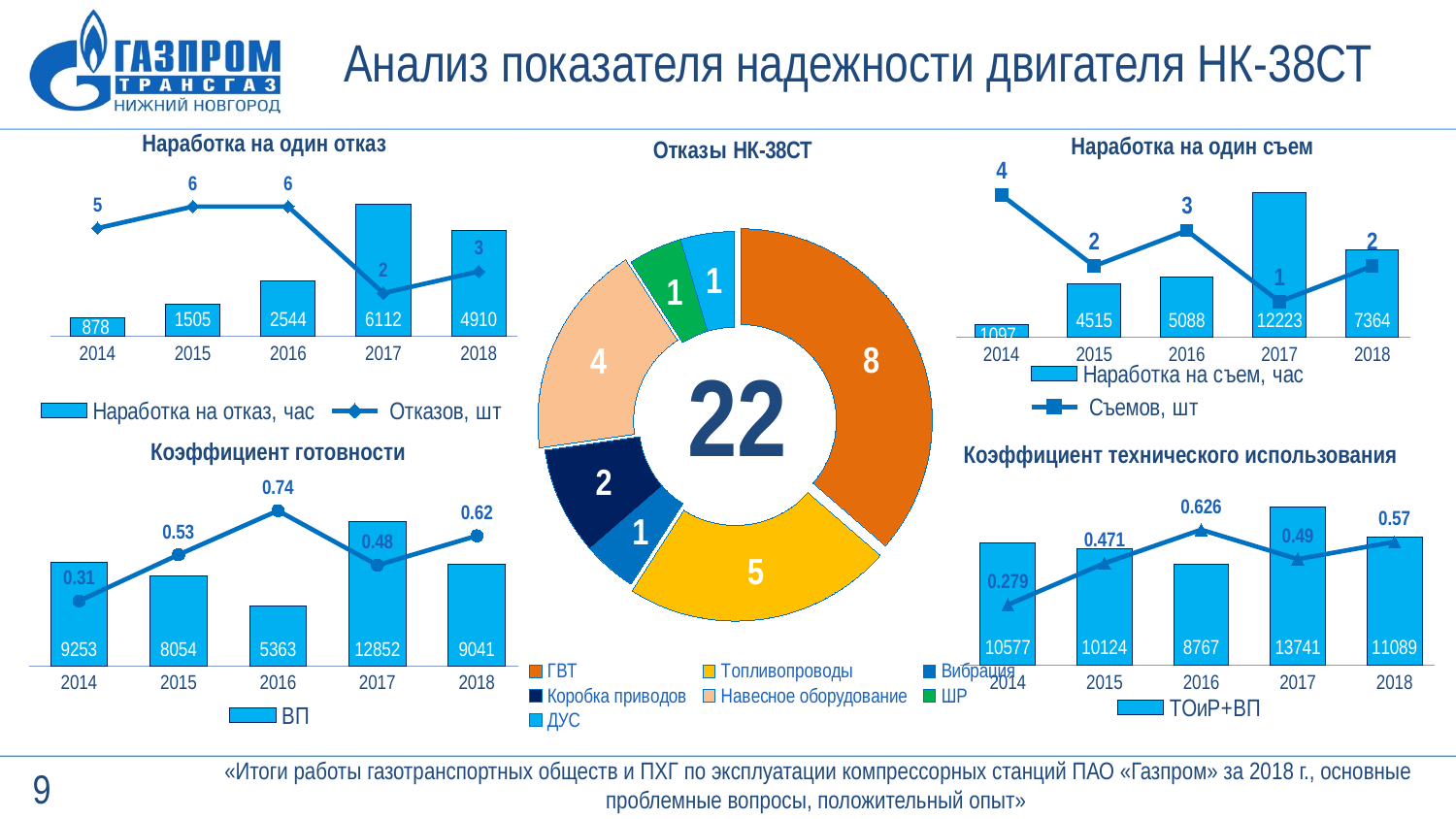
How many entries does the legend of the 'Отказы НК-38СТ' chart list? 7 How many years are shown on the x axis of the 'Коэффициент технического использования' chart? 5 In the 'Наработка на один отказ' chart, which year has the highest number of 'Отказов, шт'? 2015 and 2016 In the 'Наработка на один отказ' chart, what is the value of 'Наработка на отказ, час' for 2017? 6112 In the 'Отказы НК-38СТ' donut chart, what is the value for 'ГВТ'? 8 In the 'Коэффициент готовности' chart, which is larger: the 'ВП' bar for 2017 or for 2014? 2017 In the 'Отказы НК-38СТ' chart, what is the difference between the 'ГВТ' value and the 'Топливопроводы' value? 3 In the 'Коэффициент готовности' chart, what is the line value for 2016? 0.74 In the 'Коэффициент технического использования' chart, what is the 'ТОиР+ВП' value for 2016? 8767 In the 'Отказы НК-38СТ' donut chart, what is the total number shown in the centre? 22 In the 'Наработка на один съем' chart, what is the value of 'Наработка на съем, час' for 2018? 7364 In the 'Наработка на один съем' chart, which year has the lowest 'Съемов, шт' value? 2017